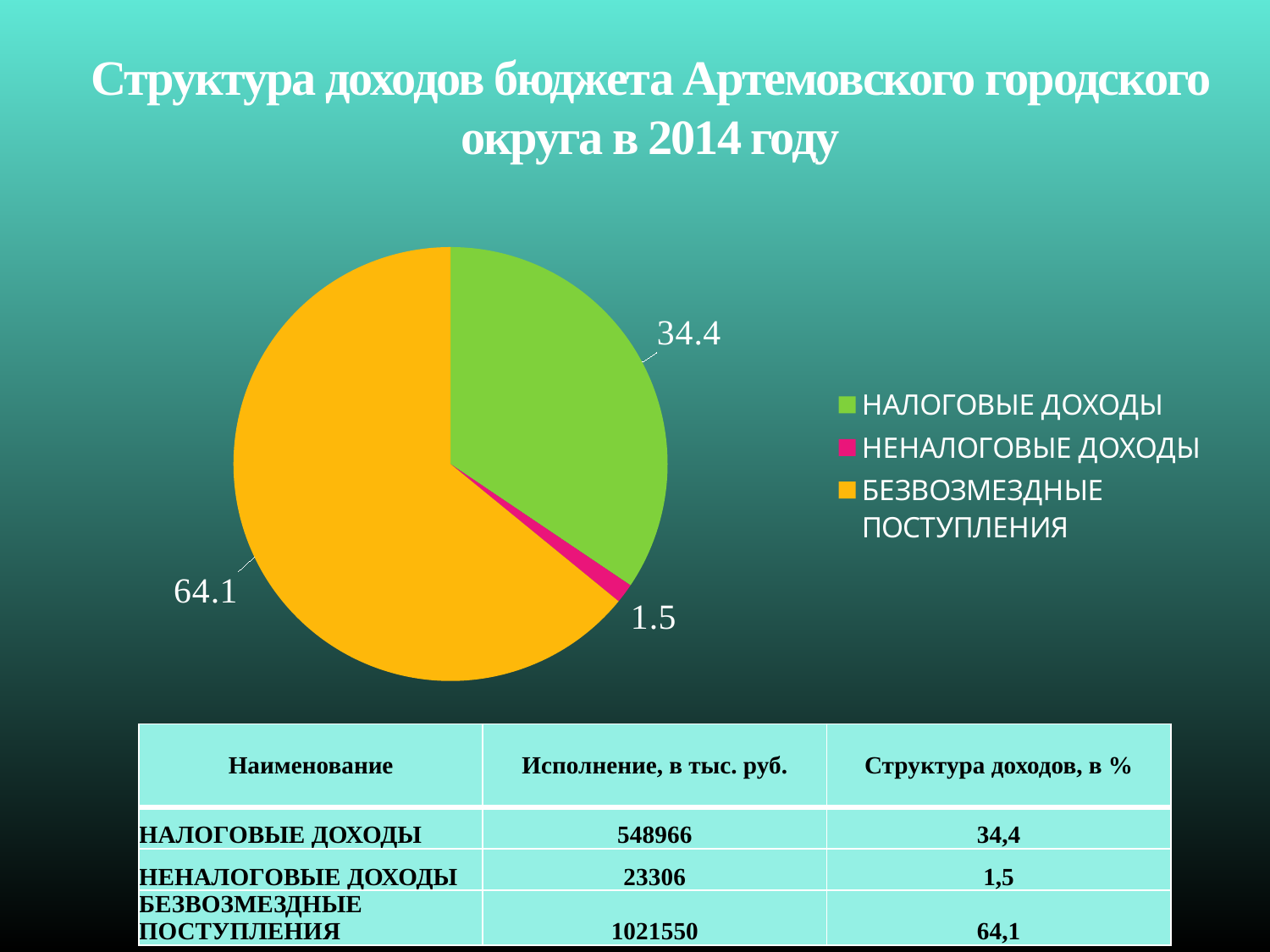
Which is larger in the pie chart, НАЛОГОВЫЕ ДОХОДЫ or НЕНАЛОГОВЫЕ ДОХОДЫ? НАЛОГОВЫЕ ДОХОДЫ How many entries does the legend of the pie chart list? 3 What kind of chart is shown on the slide? pie chart What value is shown for БЕЗВОЗМЕЗДНЫЕ ПОСТУПЛЕНИЯ in the pie chart? 64.1 What is the difference between the values for БЕЗВОЗМЕЗДНЫЕ ПОСТУПЛЕНИЯ and НАЛОГОВЫЕ ДОХОДЫ in the pie chart? 29.7 What colour is the БЕЗВОЗМЕЗДНЫЕ ПОСТУПЛЕНИЯ slice in the pie chart? orange Which category has the largest slice of the pie chart? БЕЗВОЗМЕЗДНЫЕ ПОСТУПЛЕНИЯ What share of the pie does the НАЛОГОВЫЕ ДОХОДЫ slice represent? 34.4 What value is shown for НАЛОГОВЫЕ ДОХОДЫ in the pie chart? 34.4 What value is shown for НЕНАЛОГОВЫЕ ДОХОДЫ in the pie chart? 1.5 How many slices does the pie chart have? 3 Which category has the smallest slice of the pie chart? НЕНАЛОГОВЫЕ ДОХОДЫ